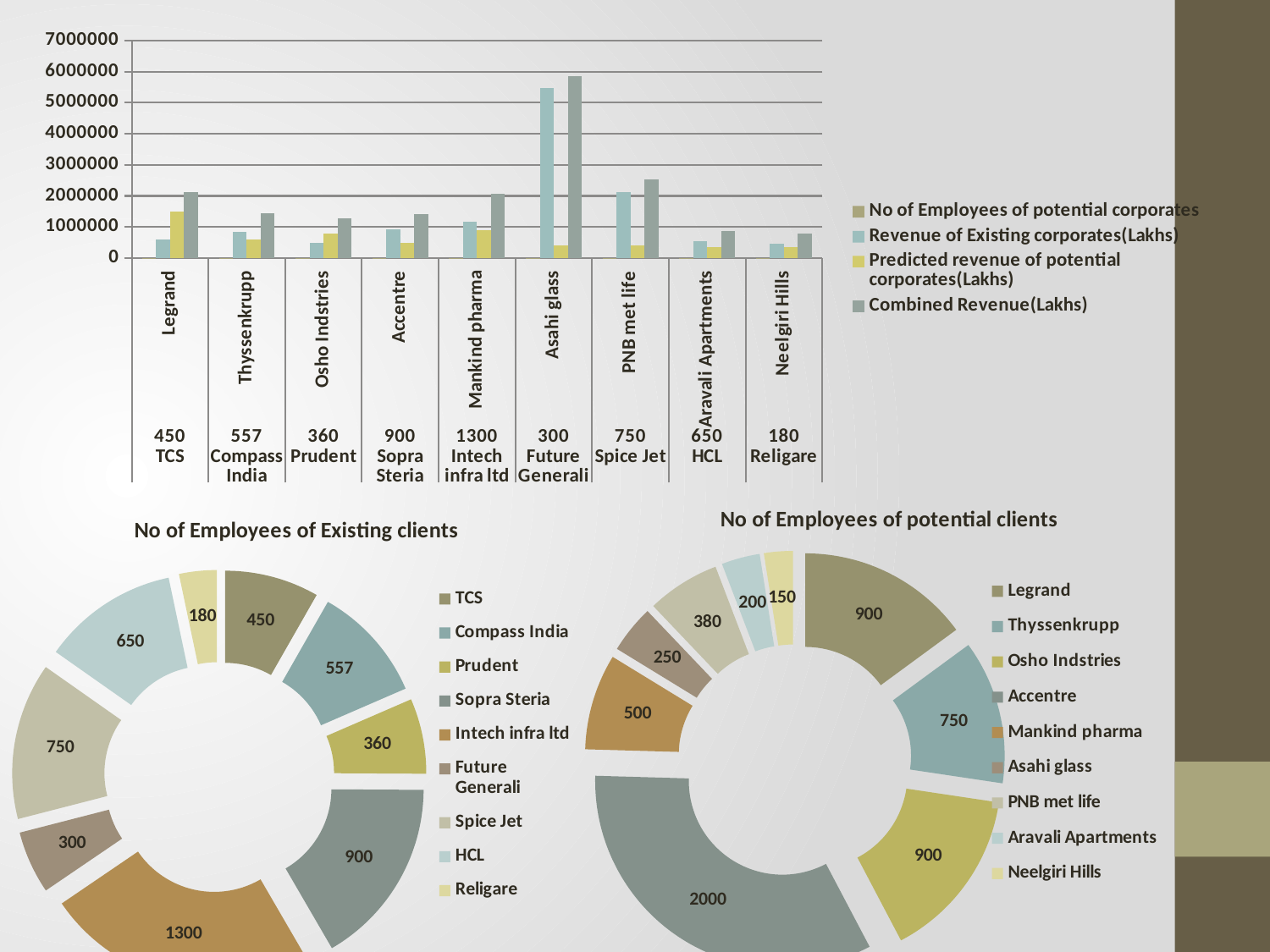
In the 'No of Employees of potential clients' chart, what is the value for Accentre? 2000 In the 'No of Employees of Existing clients' chart, what is the difference between Sopra Steria and Prudent? 540 In the 'No of Employees of Existing clients' chart, which client has the lowest number of employees? Religare In the 'No of Employees of Existing clients' chart, what is the value for Intech infra ltd? 1300 In the top bar chart, which category has the highest Combined Revenue(Lakhs)? Asahi glass In the 'No of Employees of potential clients' chart, which is larger: Thyssenkrupp or Mankind pharma? Thyssenkrupp What kind of chart is the chart at the top of the slide? bar chart In the top bar chart, is the Combined Revenue(Lakhs) for PNB met life greater or less than 2000000? greater In the top bar chart, is the Combined Revenue(Lakhs) for Asahi glass greater or less than 5000000? greater How many series does the legend of the top bar chart list? 4 In the top bar chart, which is larger: the Combined Revenue(Lakhs) for Asahi glass or for Legrand? Asahi glass In the 'No of Employees of potential clients' chart, how many categories are shown? 9